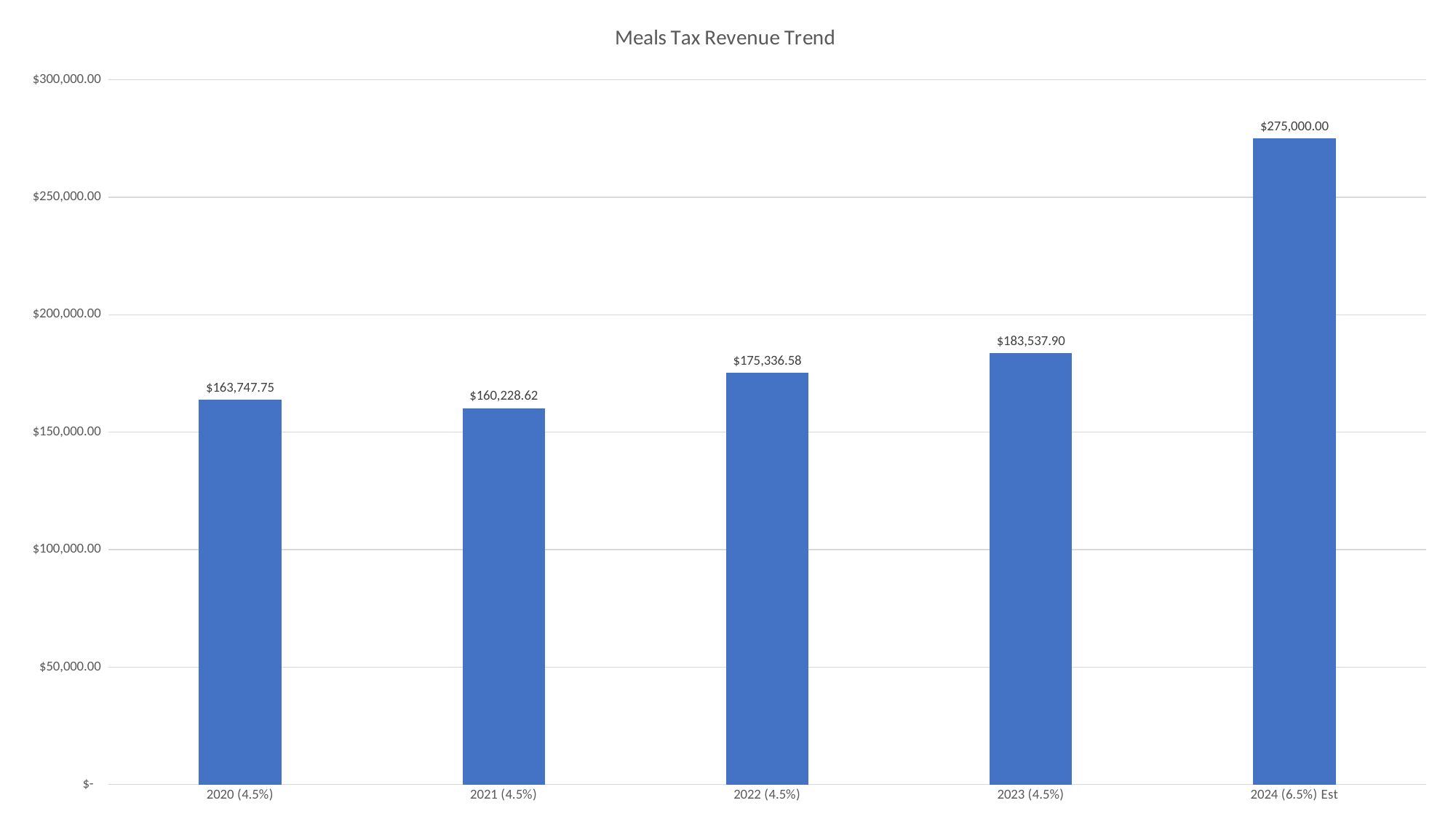
What is the estimated meals tax revenue for 2024 (6.5%) Est? $275,000.00 What is the meals tax revenue for 2022 (4.5%)? $175,336.58 Which year has the lowest meals tax revenue? 2021 (4.5%) What is the title of the chart? Meals Tax Revenue Trend Which year has the highest meals tax revenue? 2024 (6.5%) Est What kind of chart is shown on the slide? Bar chart What is the meals tax revenue for 2020 (4.5%)? $163,747.75 How many years are shown on the chart? 5 How much higher is the 2024 (6.5%) Est value than the 2023 (4.5%) value? $91,462.10 Which is larger, the revenue for 2020 (4.5%) or 2021 (4.5%)? 2020 (4.5%) What is the difference between the 2023 (4.5%) and 2022 (4.5%) revenue values? $8,201.32 Is the value for 2023 (4.5%) greater or less than $200,000.00? less